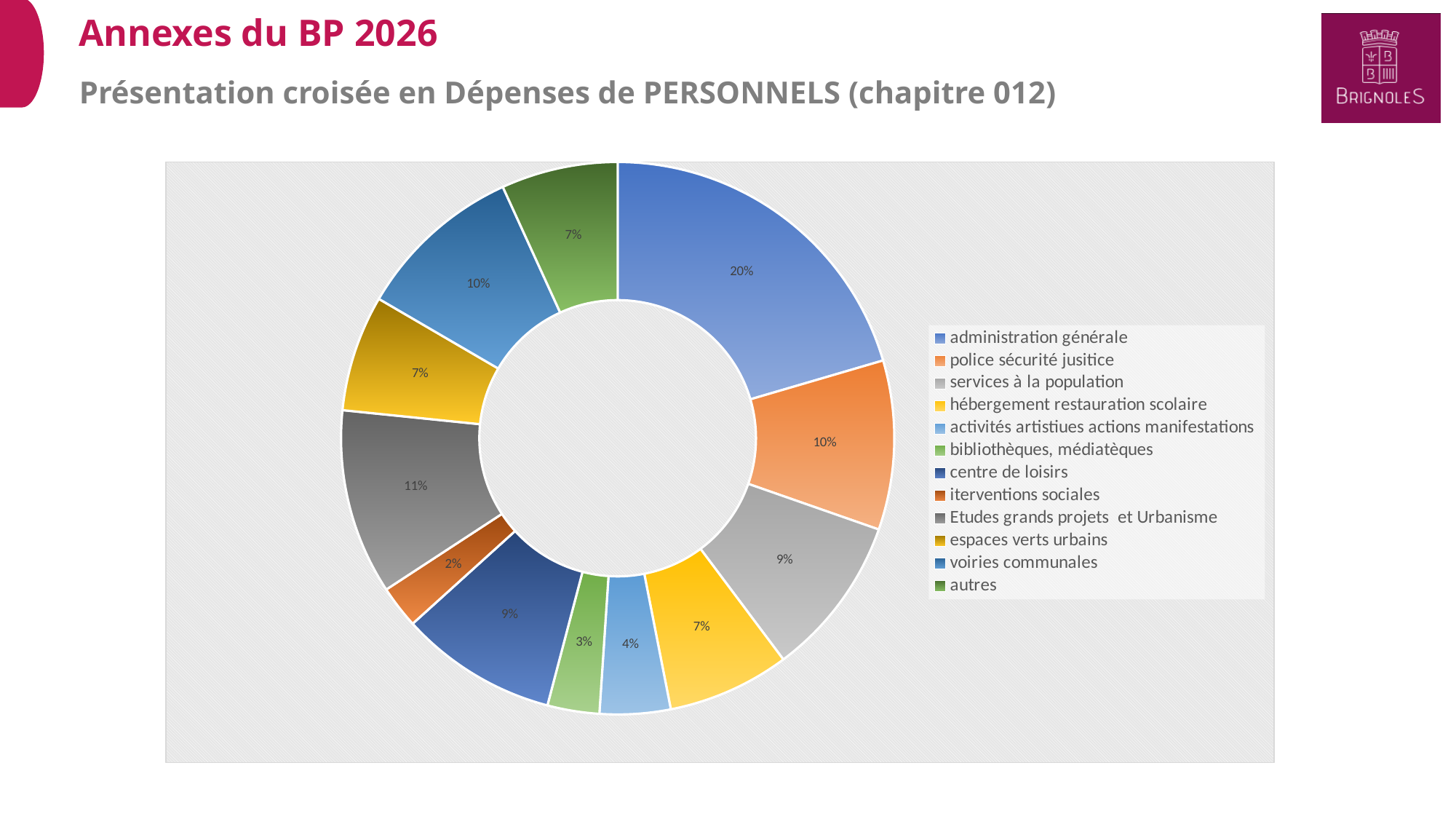
Which category has the largest share of the chart? administration générale What percentage is shown for bibliothèques, médiatèques? 3% Which category has the smallest share of the chart? iterventions sociales What percentage is shown for iterventions sociales? 2% What percentage is shown for Etudes grands projets et Urbanisme? 11% What kind of chart is shown on the slide? Doughnut (pie) chart What is the difference in percentage points between administration générale and police sécurité jusitice? 10 What colour is the slice for hébergement restauration scolaire? Yellow Which is larger, the share for Etudes grands projets et Urbanisme or the share for centre de loisirs? Etudes grands projets et Urbanisme How many categories does the legend list? 12 What percentage is shown for voiries communales? 10% What share of personnel expenses goes to administration générale? 20%